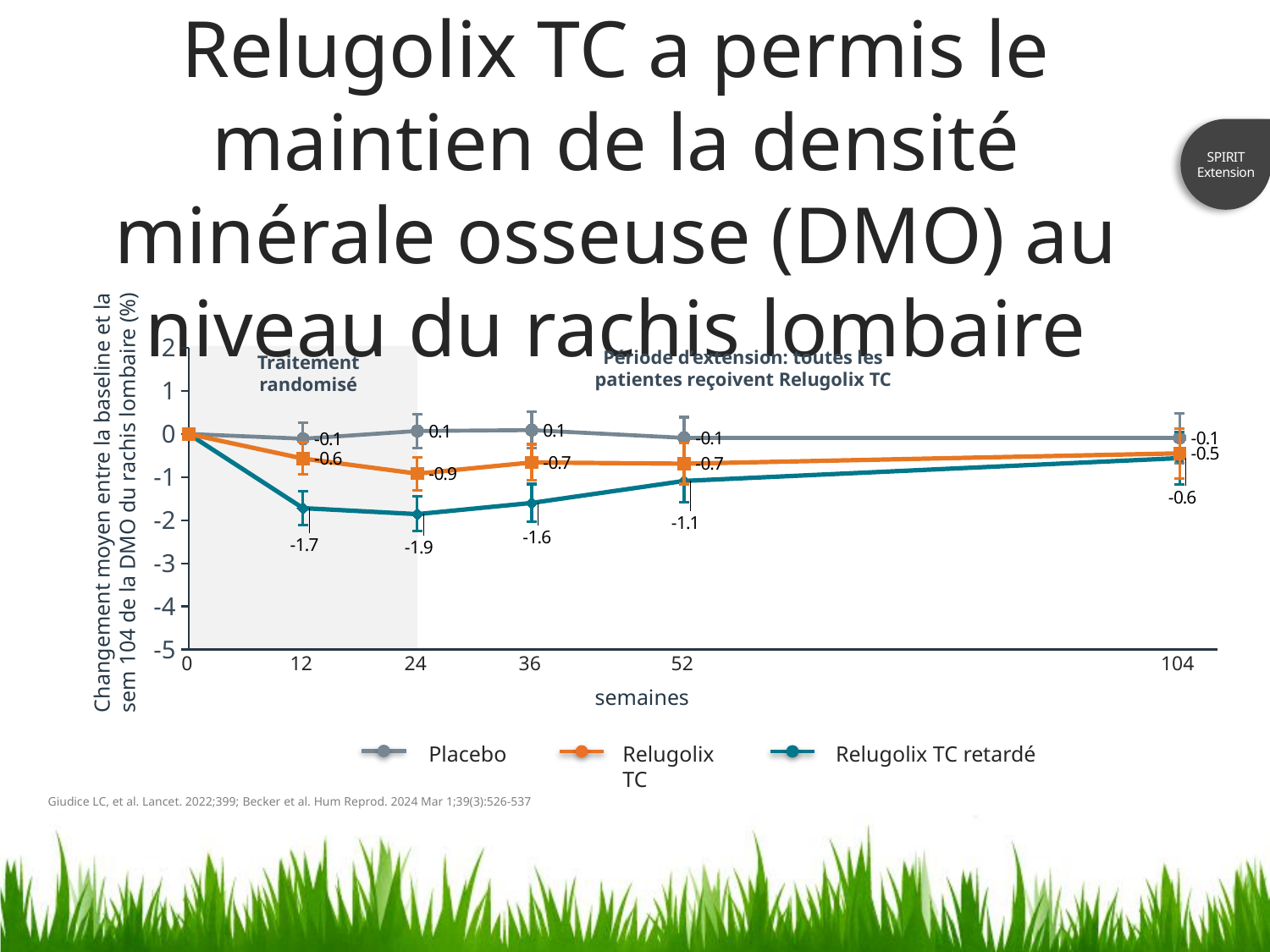
What kind of chart is shown on the slide? line chart What is the value for Relugolix TC at week 12? -0.6 How many time points are labelled on the x axis? 6 What is the value for Relugolix TC retardé at week 24? -1.9 What is the label of the x axis? semaines Which series has the lower value at week 12, Relugolix TC or Relugolix TC retardé? Relugolix TC retardé At which week does Relugolix TC retardé reach its lowest value? 24 What is the difference between the Relugolix TC retardé value and the Relugolix TC value at week 24? 1.0 How many series does the legend list? 3 Does the Relugolix TC retardé series rise or fall between week 24 and week 104? rise What is the value for Placebo at week 36? 0.1 What is the value for Relugolix TC retardé at week 104? -0.6